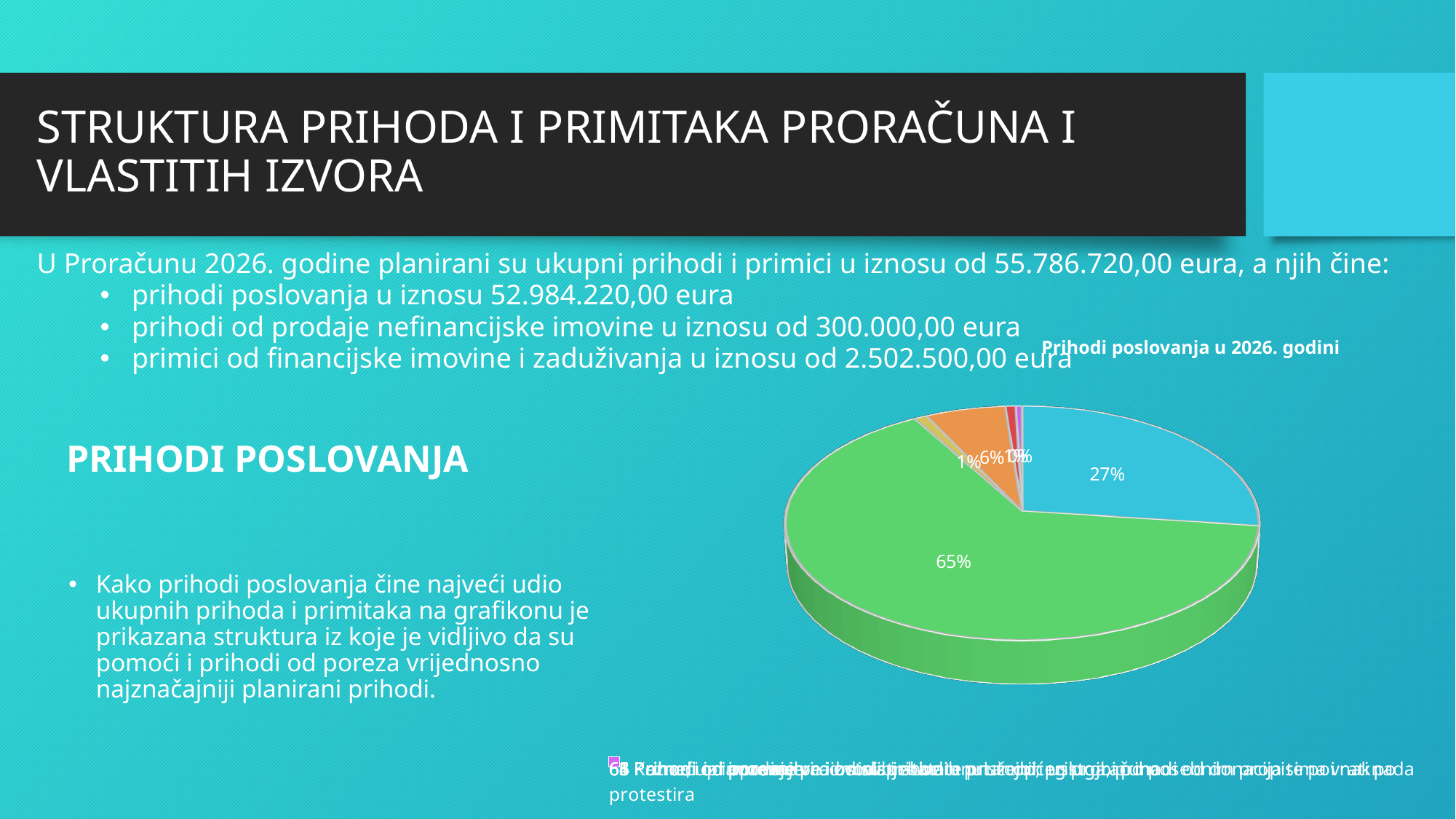
Does the blue slice of the pie chart represent more or less than half of the total? less Which slice is larger in the pie chart, the green one or the blue one? green What share does the orange slice of the pie chart represent? 6% What colour is the largest slice of the pie chart? green What share does the green slice of the pie chart represent? 65% What is the share of the largest slice in the pie chart? 65% What is the title of the pie chart? Prihodi poslovanja u 2026. godini What kind of chart is shown on the slide? pie chart By how many percentage points does the green slice (65%) exceed the blue slice (27%)? 38 percentage points What share does the blue slice of the pie chart represent? 27%